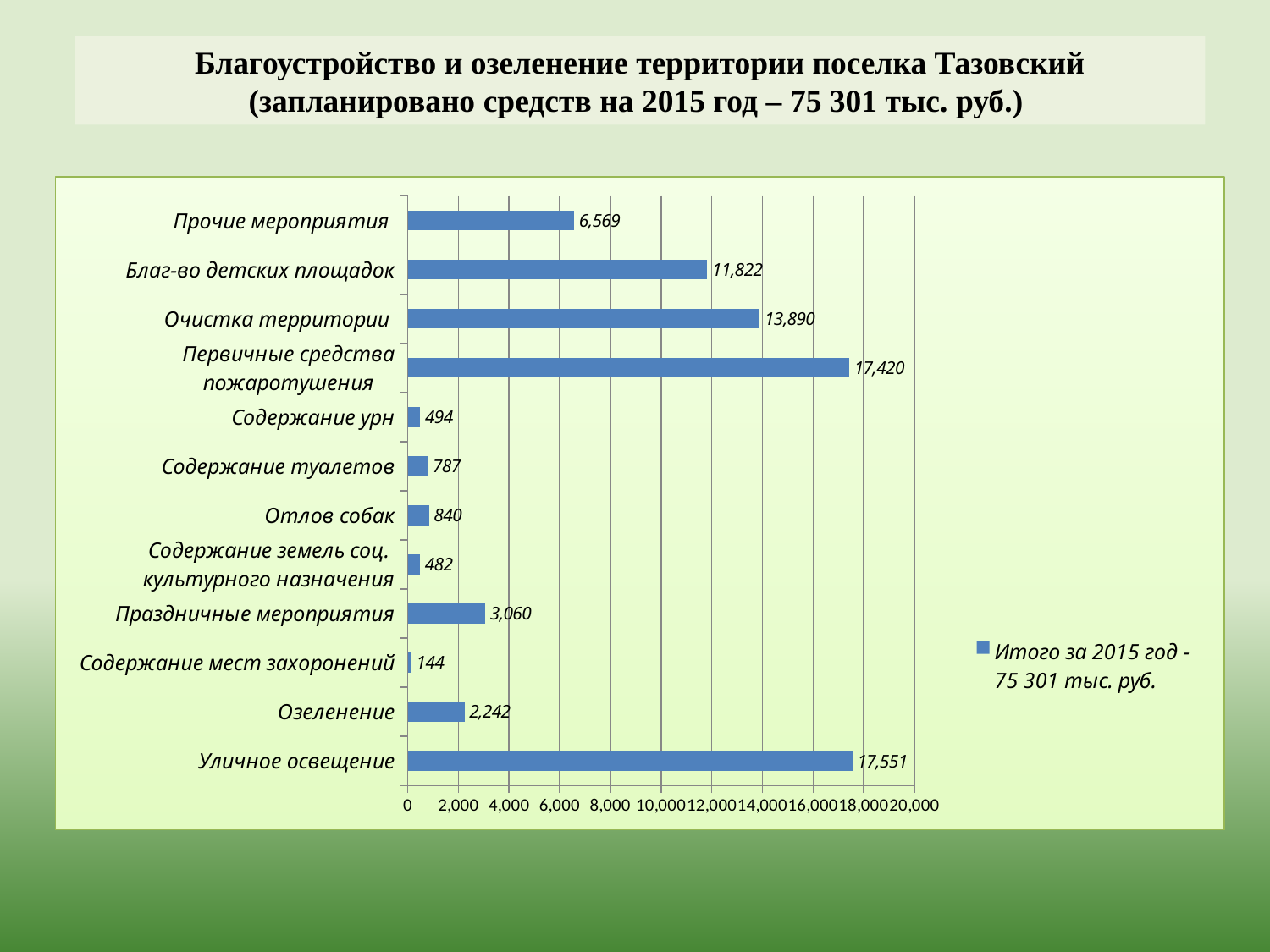
What is the value for Очистка территории? 13,890 Which category has the highest value? Уличное освещение What is the value for Уличное освещение? 17,551 Which category has the lowest value? Содержание мест захоронений Is the value for Праздничные мероприятия greater or less than 4,000? less How many categories are shown in the chart? 12 Which is larger, the value for Отлов собак or the value for Содержание туалетов? Отлов собак What is the legend entry for the series in the chart? Итого за 2015 год - 75 301 тыс. руб. What is the value for Содержание мест захоронений? 144 What is the difference between the values for Уличное освещение and Первичные средства пожаротушения? 131 What kind of chart is shown on the slide? bar chart What is the difference between the values for Очистка территории and Благ-во детских площадок? 2,068